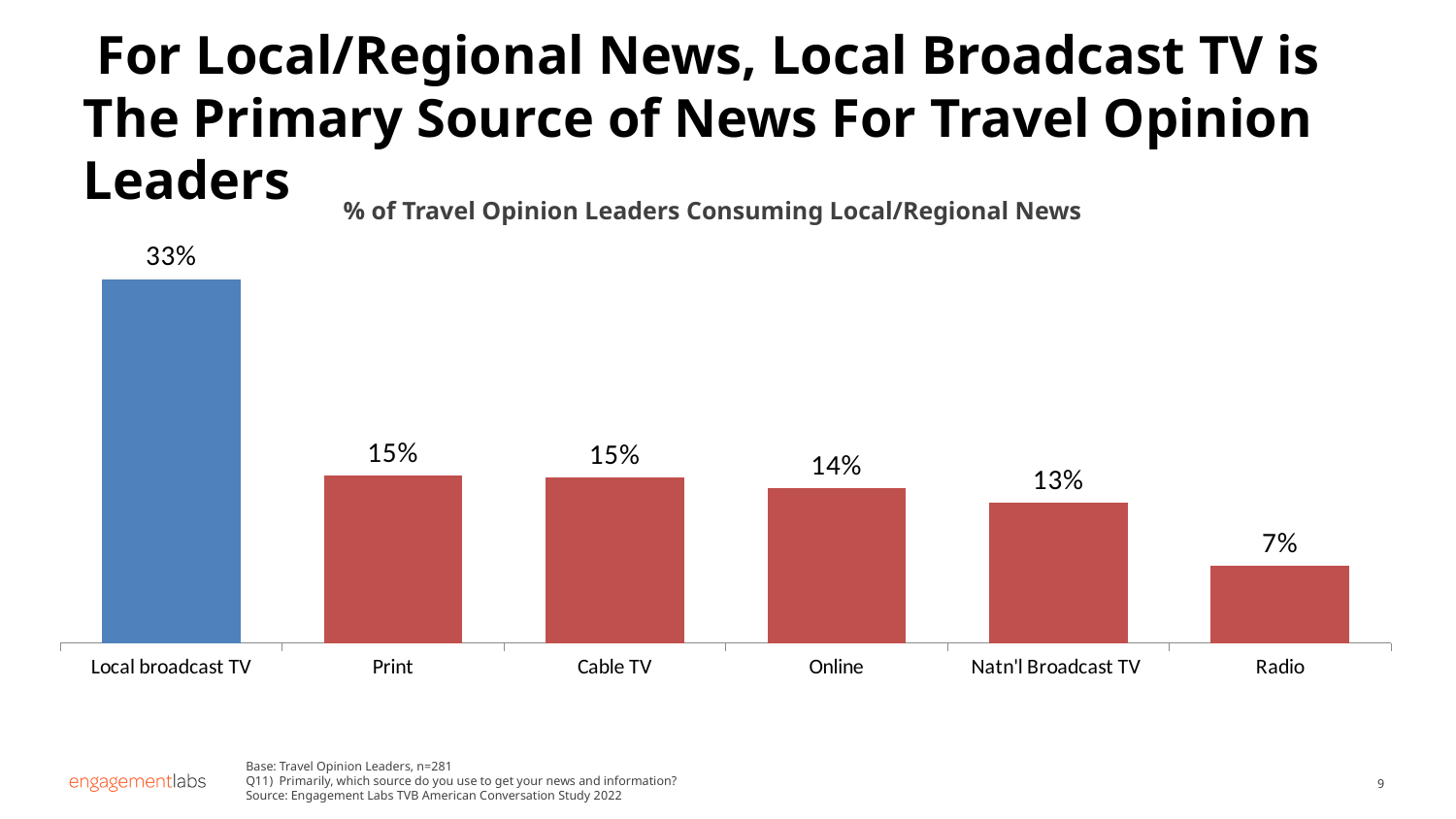
Which is larger, the value for Online or the value for Natn'l Broadcast TV? Online Which source has the highest percentage of Travel Opinion Leaders consuming local/regional news? Local broadcast TV What is the difference in percentage points between Natn'l Broadcast TV and Radio? 6 Do the values rise or fall moving from left to right along the x axis? Fall What is the difference in percentage points between Local broadcast TV and Print? 18 What is the value shown for Online? 14% What is the value shown for Radio? 7% What percentage of Travel Opinion Leaders consume local/regional news via Local broadcast TV? 33% What kind of chart is shown on the slide? Bar chart Which source has the lowest percentage? Radio What is the title of the chart? % of Travel Opinion Leaders Consuming Local/Regional News How many sources (categories) are shown on the chart? 6